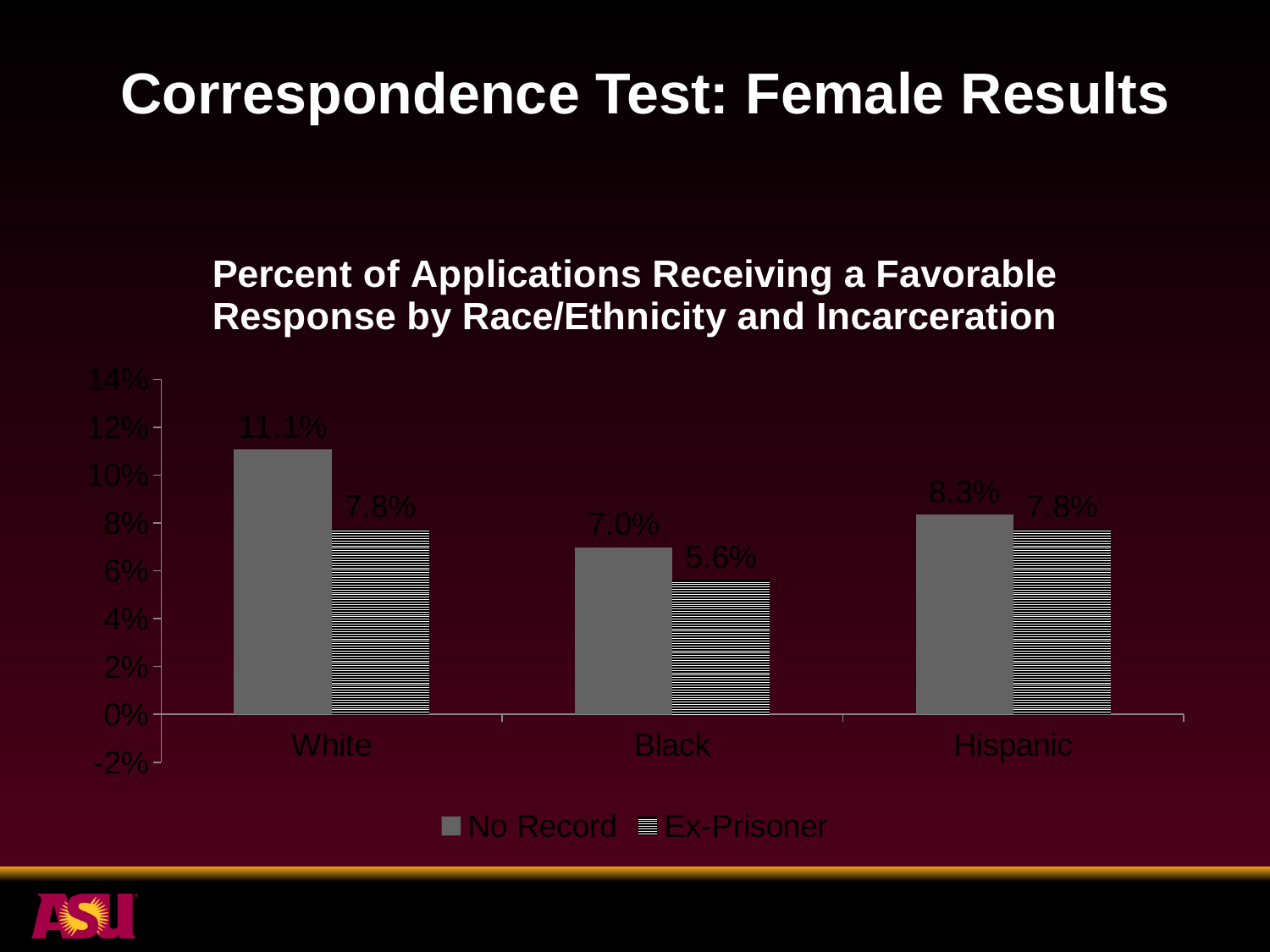
What is the No Record value for Hispanic? 8.3% What is the difference between the No Record and Ex-Prisoner values for White? 3.3% Which is larger, the No Record value for Black or the No Record value for Hispanic? Hispanic How many series does the legend list? 2 Which race/ethnicity category has the lowest Ex-Prisoner value? Black Which race/ethnicity category has the highest No Record value? White What is the No Record value for White? 11.1% What kind of chart is shown on the slide? Bar chart What is the difference between the No Record and Ex-Prisoner values for Black? 1.4% Is the No Record value for White greater or less than 10%? greater What is the Ex-Prisoner value for Black? 5.6% How many race/ethnicity categories are shown on the x axis? 3